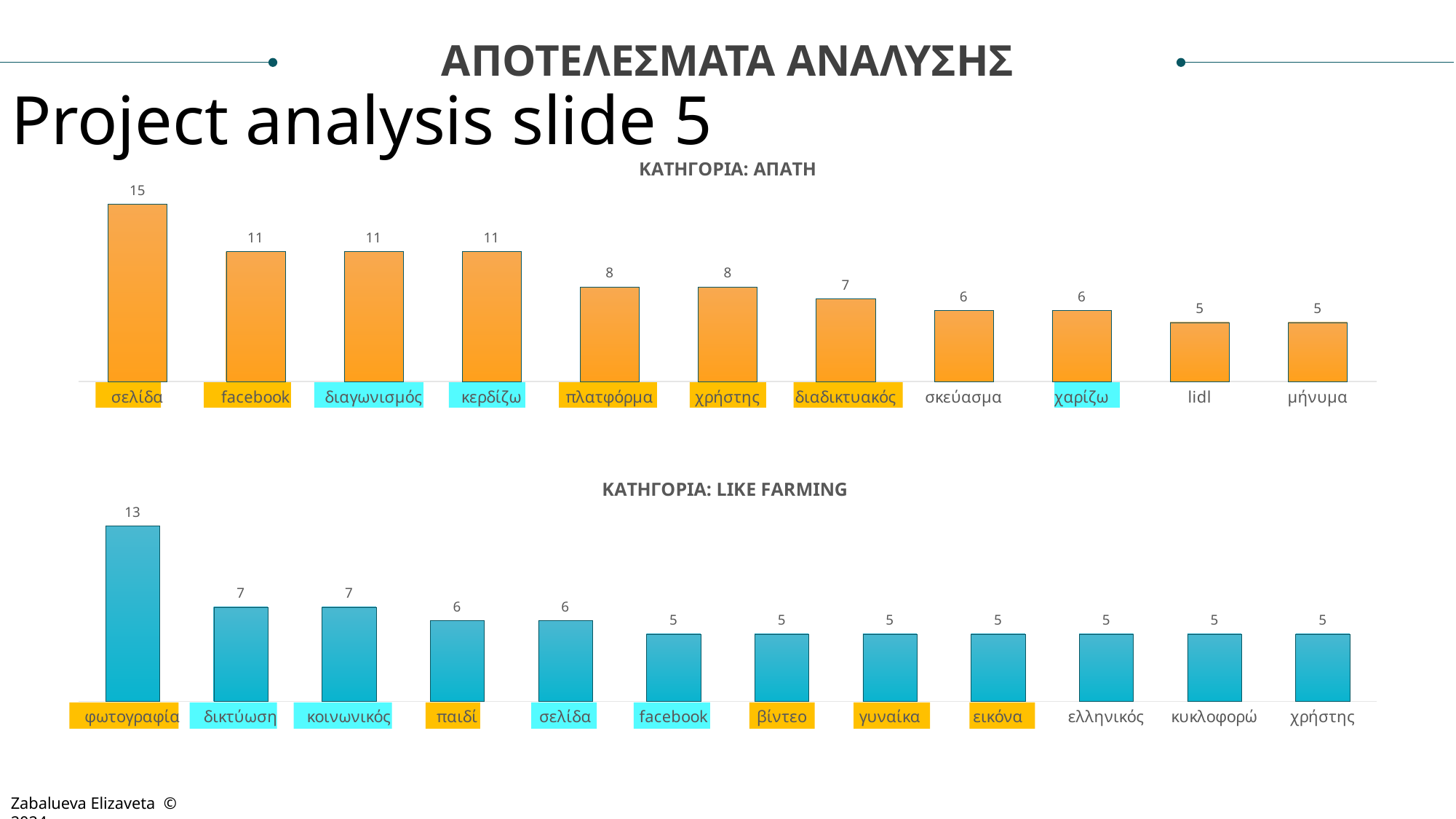
In the chart titled ΚΑΤΗΓΟΡΙΑ: LIKE FARMING, what is the value for παιδί? 6 In the chart titled ΚΑΤΗΓΟΡΙΑ: ΑΠΑΤΗ, which category has the highest value? σελίδα In the chart titled ΚΑΤΗΓΟΡΙΑ: LIKE FARMING, what is the value for φωτογραφία? 13 In the chart titled ΚΑΤΗΓΟΡΙΑ: LIKE FARMING, which category has the highest value? φωτογραφία In the chart titled ΚΑΤΗΓΟΡΙΑ: ΑΠΑΤΗ, how many categories are shown? 11 In the chart titled ΚΑΤΗΓΟΡΙΑ: ΑΠΑΤΗ, which is larger, the value for πλατφόρμα or the value for lidl? πλατφόρμα In the chart titled ΚΑΤΗΓΟΡΙΑ: LIKE FARMING, what is the difference between the values for φωτογραφία and δικτύωση? 6 In the chart titled ΚΑΤΗΓΟΡΙΑ: ΑΠΑΤΗ, what is the value for διαδικτυακός? 7 In the chart titled ΚΑΤΗΓΟΡΙΑ: ΑΠΑΤΗ, what is the value for σελίδα? 15 In the chart titled ΚΑΤΗΓΟΡΙΑ: LIKE FARMING, how many categories are shown? 12 In the chart titled ΚΑΤΗΓΟΡΙΑ: ΑΠΑΤΗ, what is the difference between the values for σελίδα and facebook? 4 What kind of chart is the chart titled ΚΑΤΗΓΟΡΙΑ: LIKE FARMING? bar chart